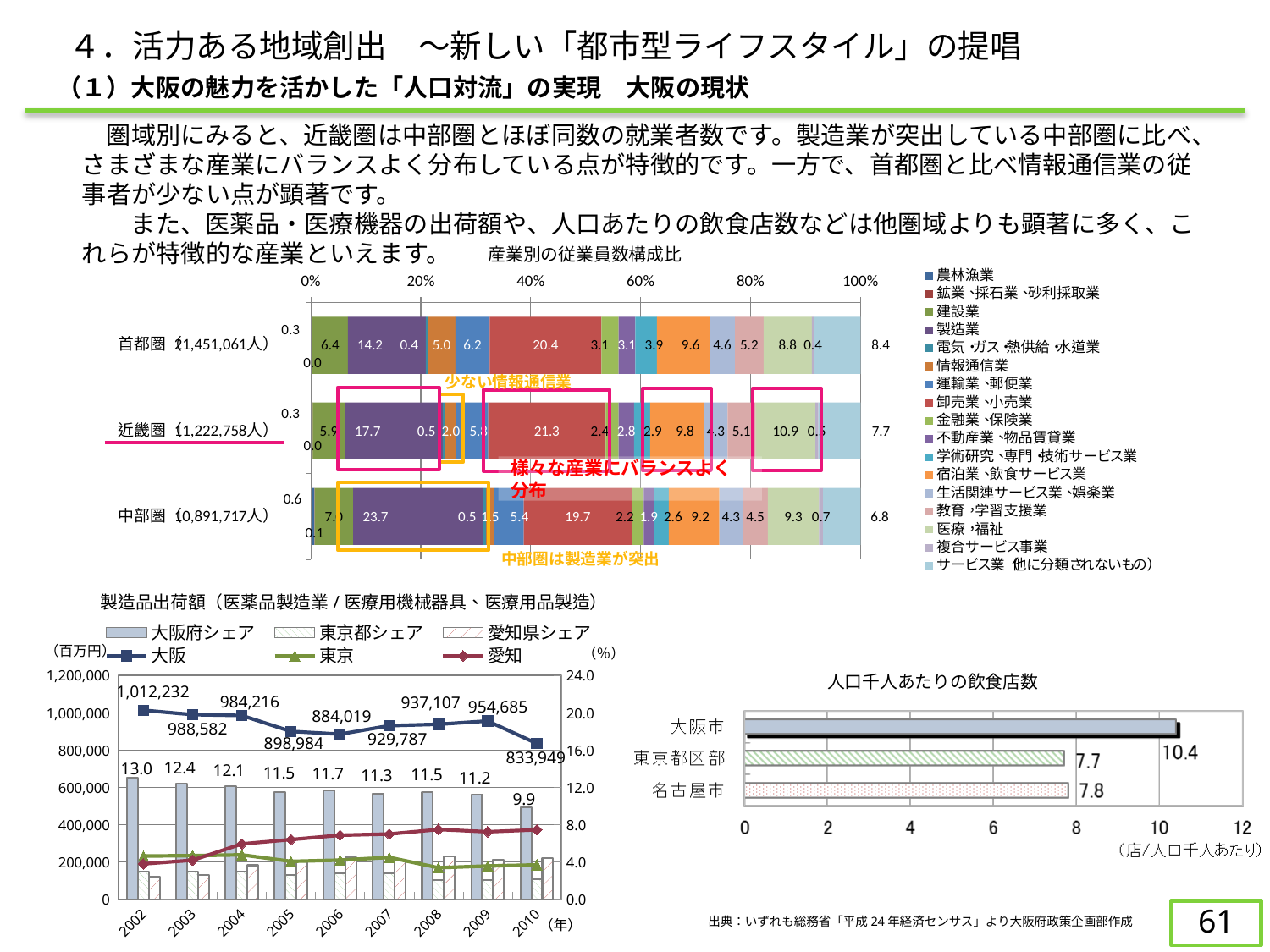
What kind of chart is the 人口千人あたりの飲食店数 chart? bar chart In the 産業別の従業員数構成比 chart, how many industry categories does the legend list? 17 In the 人口千人あたりの飲食店数 chart, how many cities are shown? 3 In the 製造品出荷額 chart, how many series does the legend list? 6 In the 製造品出荷額 chart, how many years are shown on the x axis? 9 In the 製造品出荷額 chart, what is the 大阪府シェア value for 2010? 9.9 In the 人口千人あたりの飲食店数 chart, what is the value for 大阪市? 10.4 In the 製造品出荷額 chart, what is the 大阪 value for 2002? 1,012,232 In the 人口千人あたりの飲食店数 chart, which city has the highest value? 大阪市 In the 人口千人あたりの飲食店数 chart, what is the difference between 大阪市 and 東京都区部? 2.7 In the 製造品出荷額 chart, what is the difference between the 大阪 values for 2002 and 2010? 178,283 In the 製造品出荷額 chart, in which year is the 大阪 value lowest? 2010